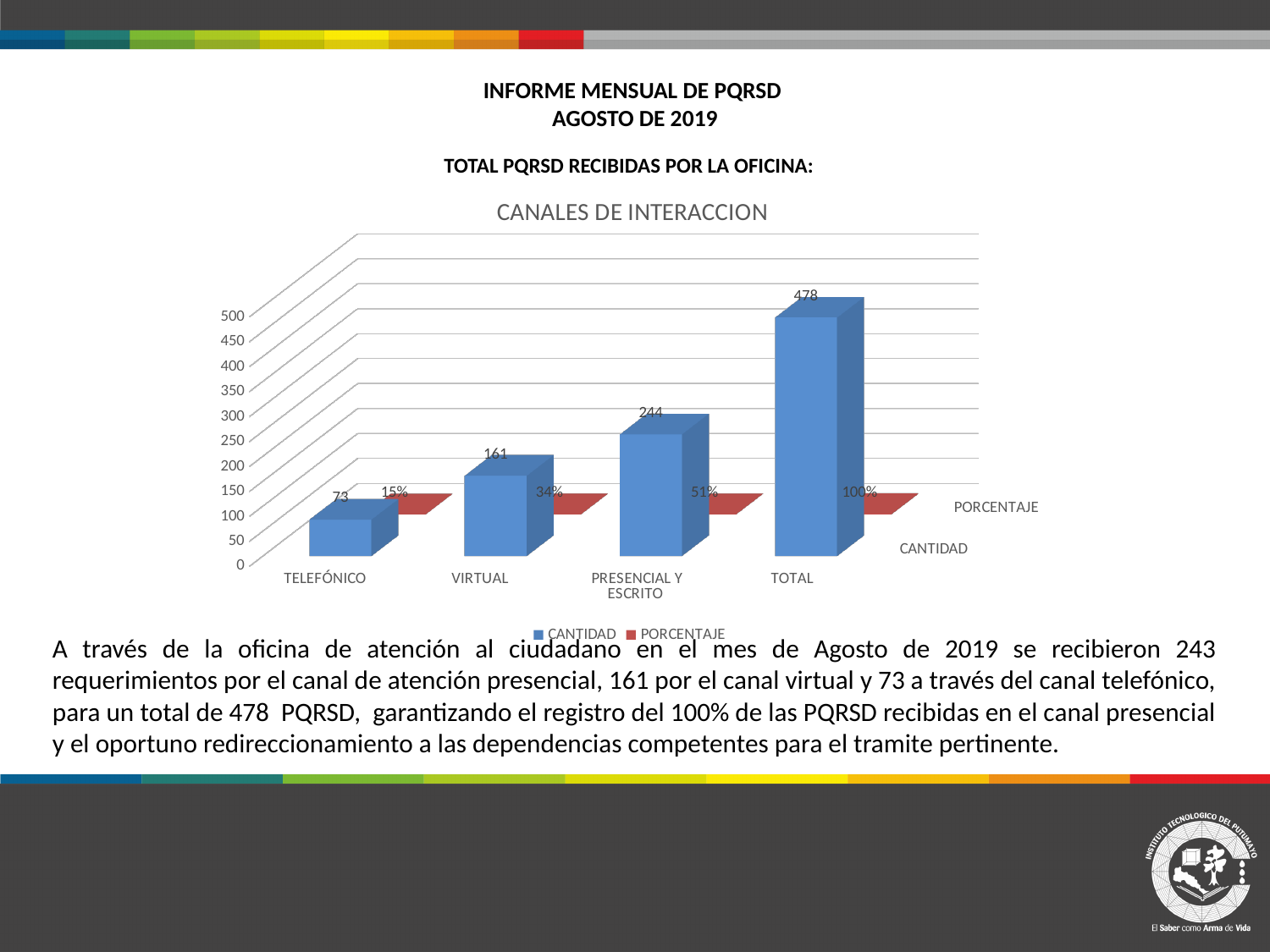
What is the CANTIDAD value for TELEFÓNICO? 73 How many categories are shown on the x axis? 4 Which category has the highest CANTIDAD value? TOTAL Which has a larger CANTIDAD value, VIRTUAL or TELEFÓNICO? VIRTUAL What is the difference between the CANTIDAD values for PRESENCIAL Y ESCRITO and VIRTUAL? 83 What is the CANTIDAD value for PRESENCIAL Y ESCRITO? 244 What is the CANTIDAD value for VIRTUAL? 161 Which category has the lowest CANTIDAD value? TELEFÓNICO What PORCENTAJE is shown for VIRTUAL? 34% What is the title of the chart? CANALES DE INTERACCION How many series does the legend list? 2 What PORCENTAJE is shown for PRESENCIAL Y ESCRITO? 51%